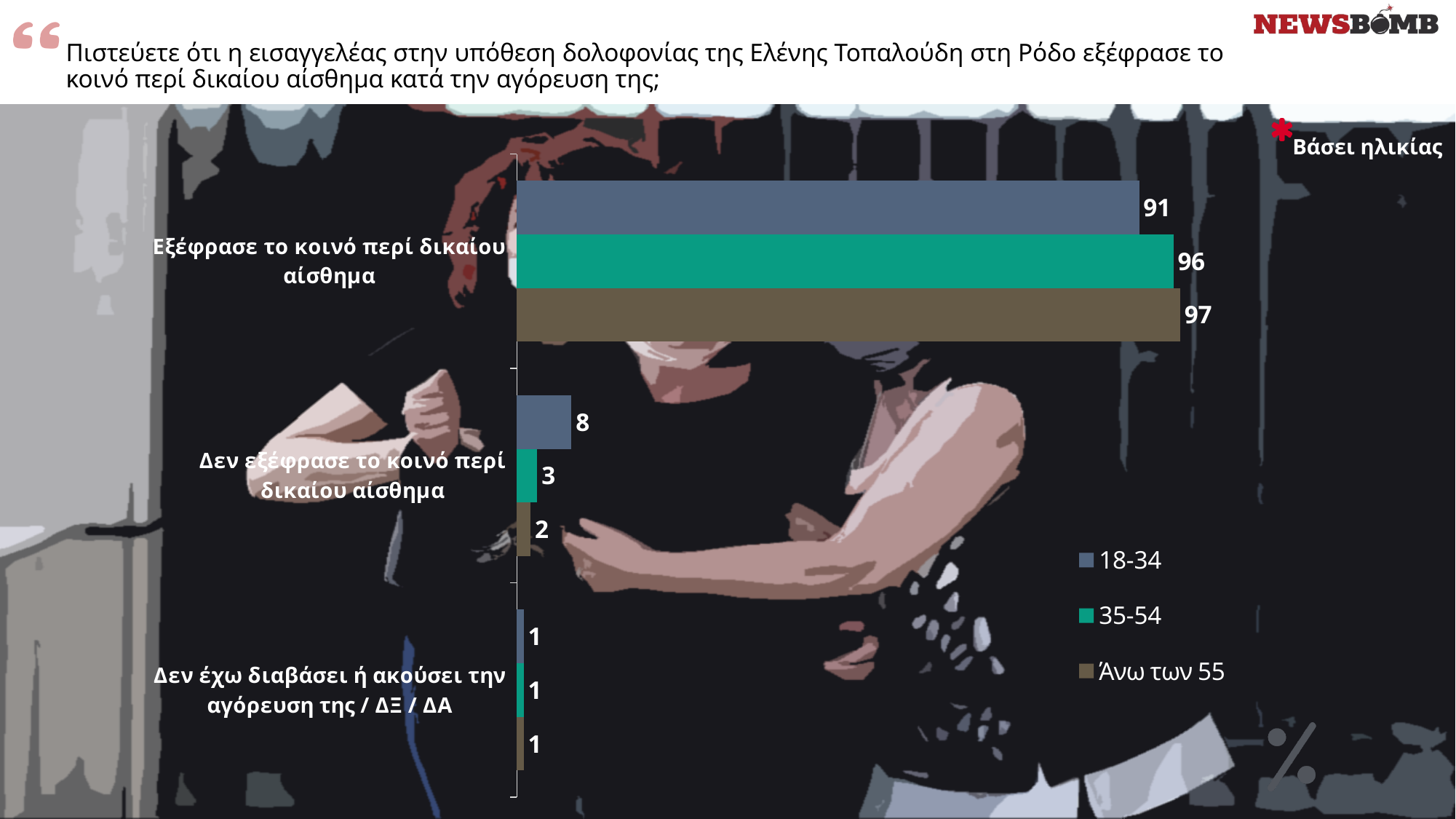
What is the value for the Άνω των 55 series in the category "Δεν εξέφρασε το κοινό περί δικαίου αίσθημα"? 2 What is the value for the 35-54 series in the category "Εξέφρασε το κοινό περί δικαίου αίσθημα"? 96 In the category "Δεν εξέφρασε το κοινό περί δικαίου αίσθημα", which is larger: the value for 18-34 or the value for 35-54? 18-34 What kind of chart is shown on the slide? bar chart How many series does the legend list? 3 What is the difference between the Άνω των 55 and 18-34 values in the category "Εξέφρασε το κοινό περί δικαίου αίσθημα"? 6 Which age group has the lowest value in the category "Δεν εξέφρασε το κοινό περί δικαίου αίσθημα"? Άνω των 55 Which legend entry is shown in green? 35-54 Which age group has the highest value in the category "Εξέφρασε το κοινό περί δικαίου αίσθημα"? Άνω των 55 What is the value for the 18-34 series in the category "Δεν εξέφρασε το κοινό περί δικαίου αίσθημα"? 8 How many categories are shown on the chart? 3 What is the value for the 18-34 series in the category "Εξέφρασε το κοινό περί δικαίου αίσθημα"? 91